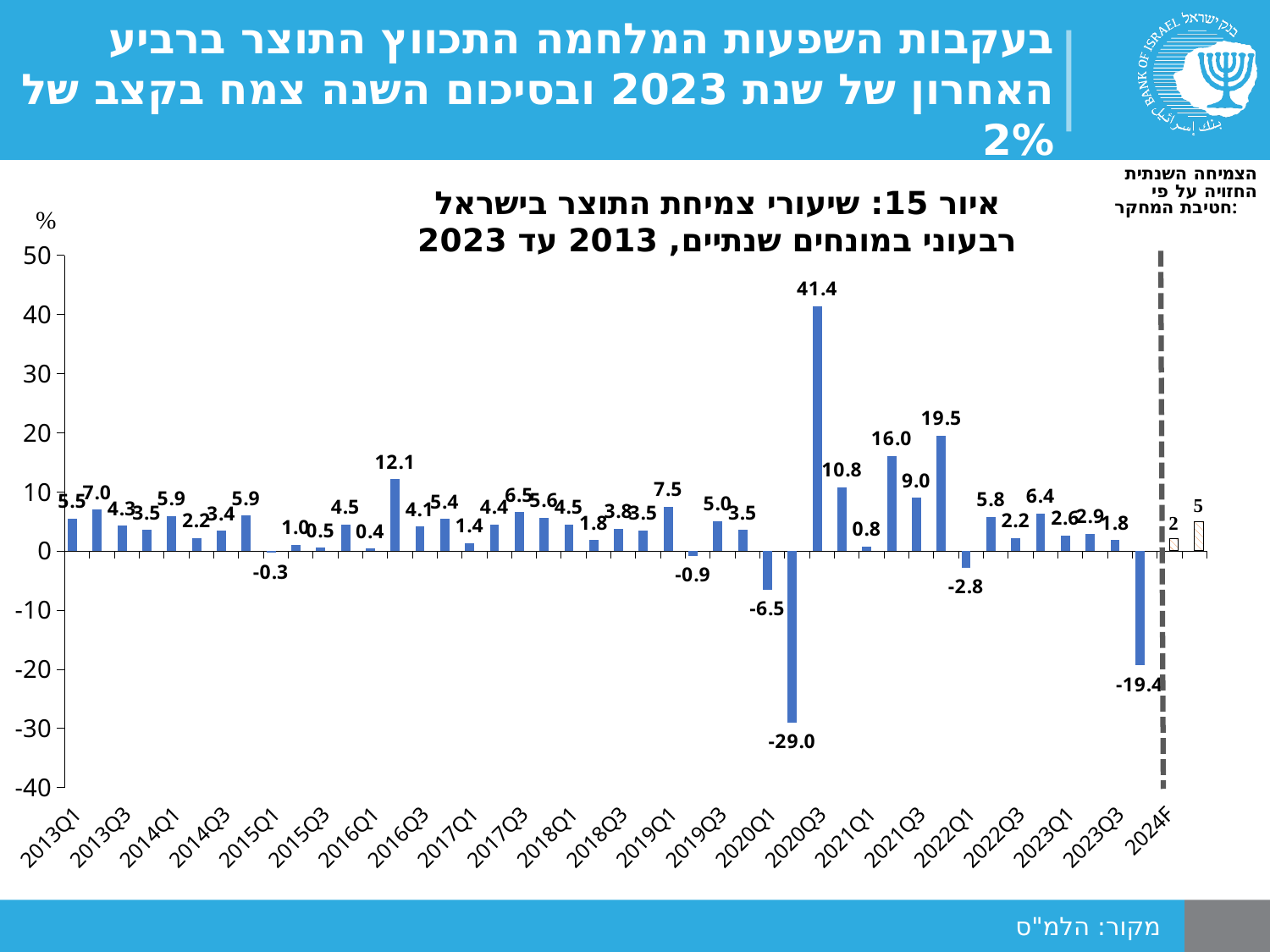
What is the lowest value shown in the chart? -29.0 What source is cited at the bottom of the slide? הלמ"ס Which quarter has the highest growth rate in the chart? 2020Q3 What is the growth rate for 2022Q1? -2.8 Which is larger, the value for 2016Q1 or the value for 2017Q1? 2017Q1 What kind of chart is shown on the slide? bar chart What is the highest value shown in the chart? 41.4 What is the growth rate for 2019Q1? 7.5 What is the growth rate for 2020Q1? -6.5 What is the difference between the values for 2020Q3 and 2021Q3? 32.4 Is the value for 2020Q3 greater or less than 40? greater What is the growth rate for 2023Q3? 1.8